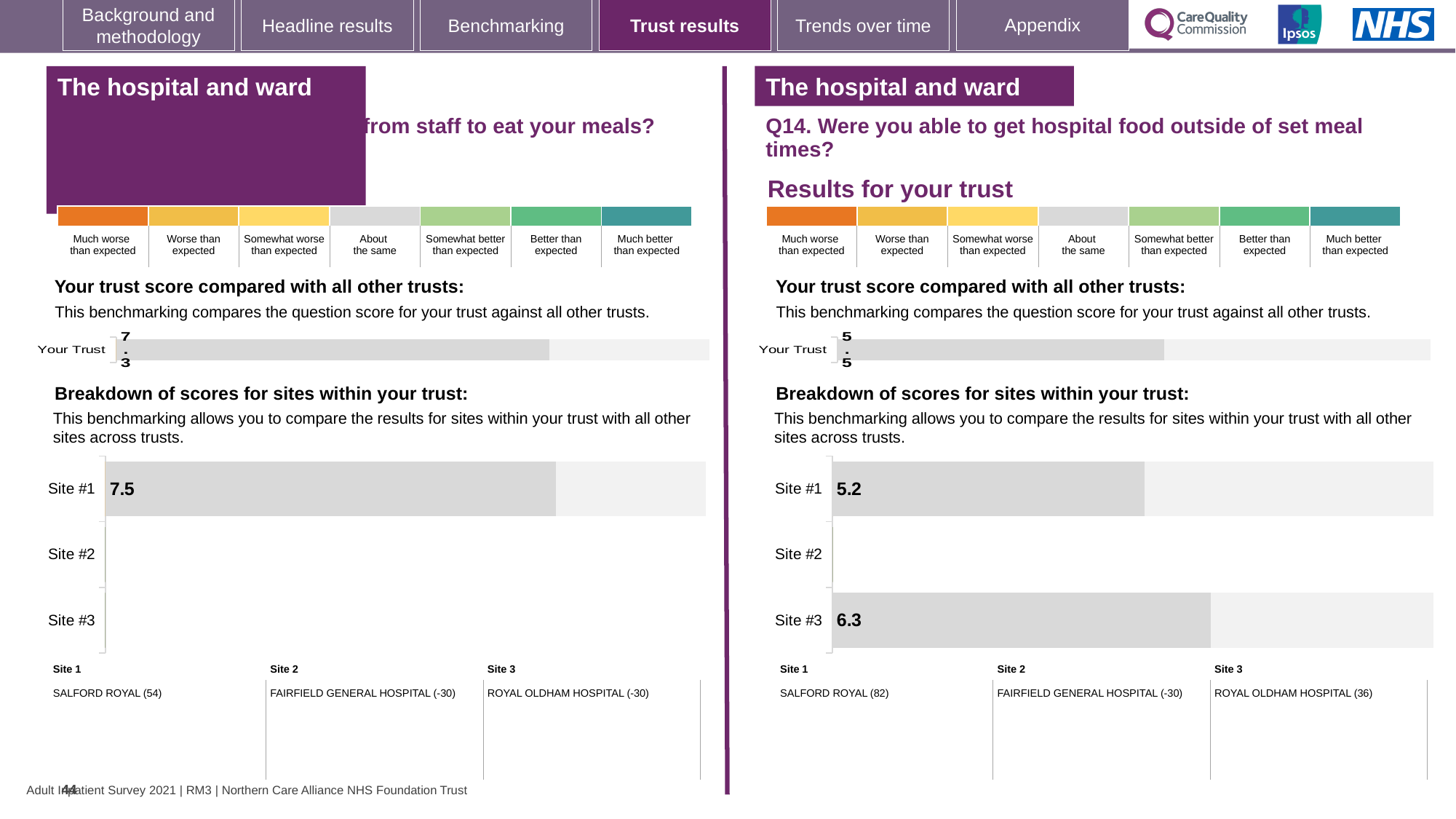
On the right-hand chart for Q14 (hospital food outside of set meal times), what is the score for Site #1? 5.2 On the right-hand site breakdown chart for Q14, what is the difference between the Site #3 score and the Site #1 score? 1.1 On the left-hand 'Your trust score compared with all other trusts' chart, what is the score shown for Your Trust? 7.3 On the left-hand site breakdown chart, what is the score for Site #1? 7.5 How many site categories are listed on the left-hand site breakdown chart? 3 Which hospital is listed as Site 1 in the key below the right-hand chart? SALFORD ROYAL (82) On the right-hand chart for Q14 (hospital food outside of set meal times), what is the score for Site #3? 6.3 On the right-hand site breakdown chart for Q14, which site has the highest score? Site #3 On the right-hand site breakdown chart for Q14, which site has no bar or score shown? Site #2 What type of chart is used for the site breakdown on the right-hand side of the slide? Bar chart On the right-hand 'Your trust score compared with all other trusts' chart for Q14, what is the score shown for Your Trust? 5.5 On the right-hand site breakdown chart for Q14, which site has the higher score, Site #1 or Site #3? Site #3